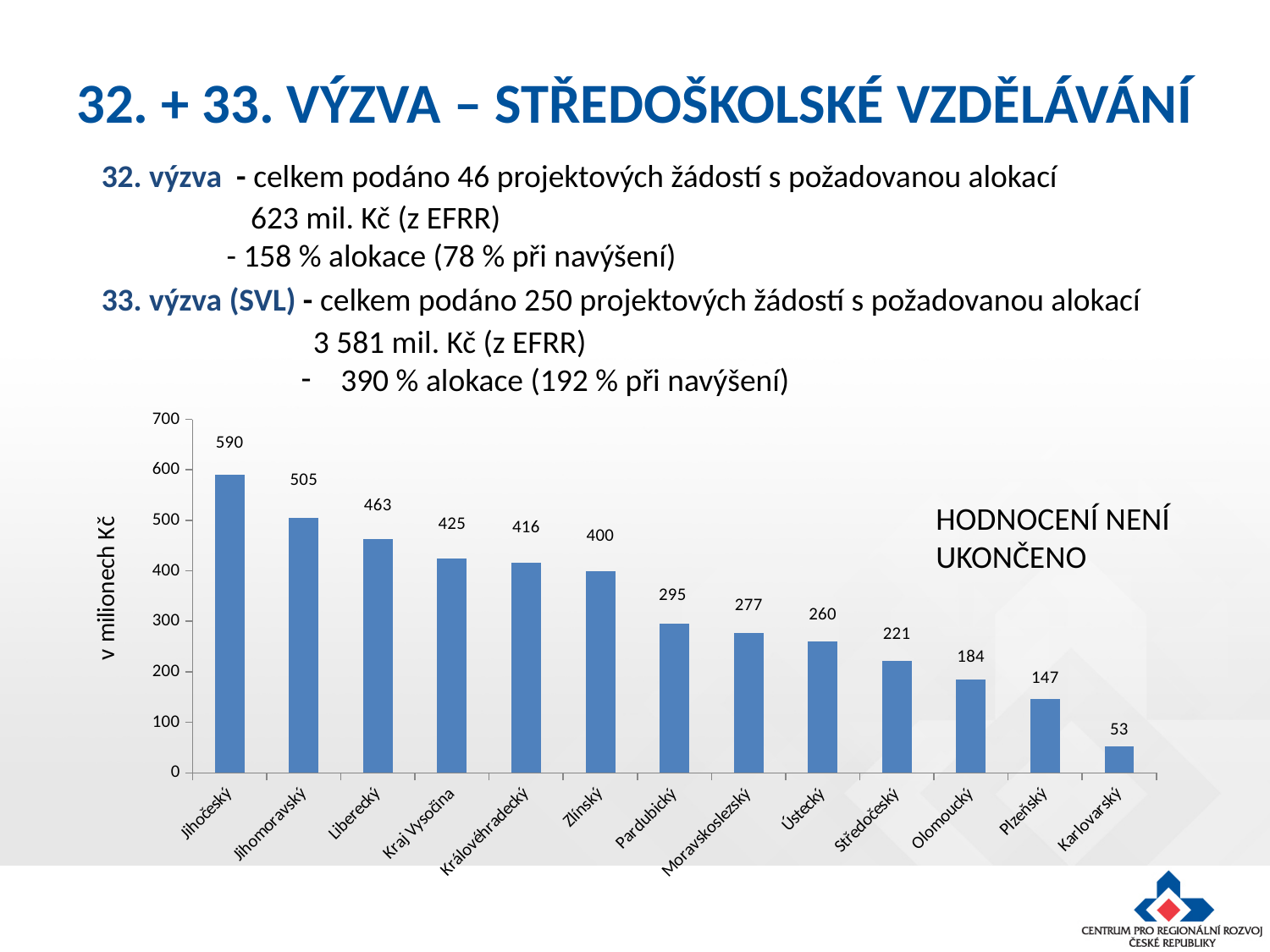
Is the value for Plzeňský greater or less than 200? less Which is larger, the value for Ústecký or the value for Středočeský? Ústecký Which region has the lowest value? Karlovarský What is the value for Olomoucký? 184 What is the difference between the values for Jihomoravský and Liberecký? 42 Which region has the highest value? Jihočeský How many regions are shown on the x axis? 13 What kind of chart is shown? bar chart What is the value for Pardubický? 295 What is the label of the vertical axis? v milionech Kč Do the values rise or fall from left to right along the x axis? fall What is the value for Jihočeský? 590